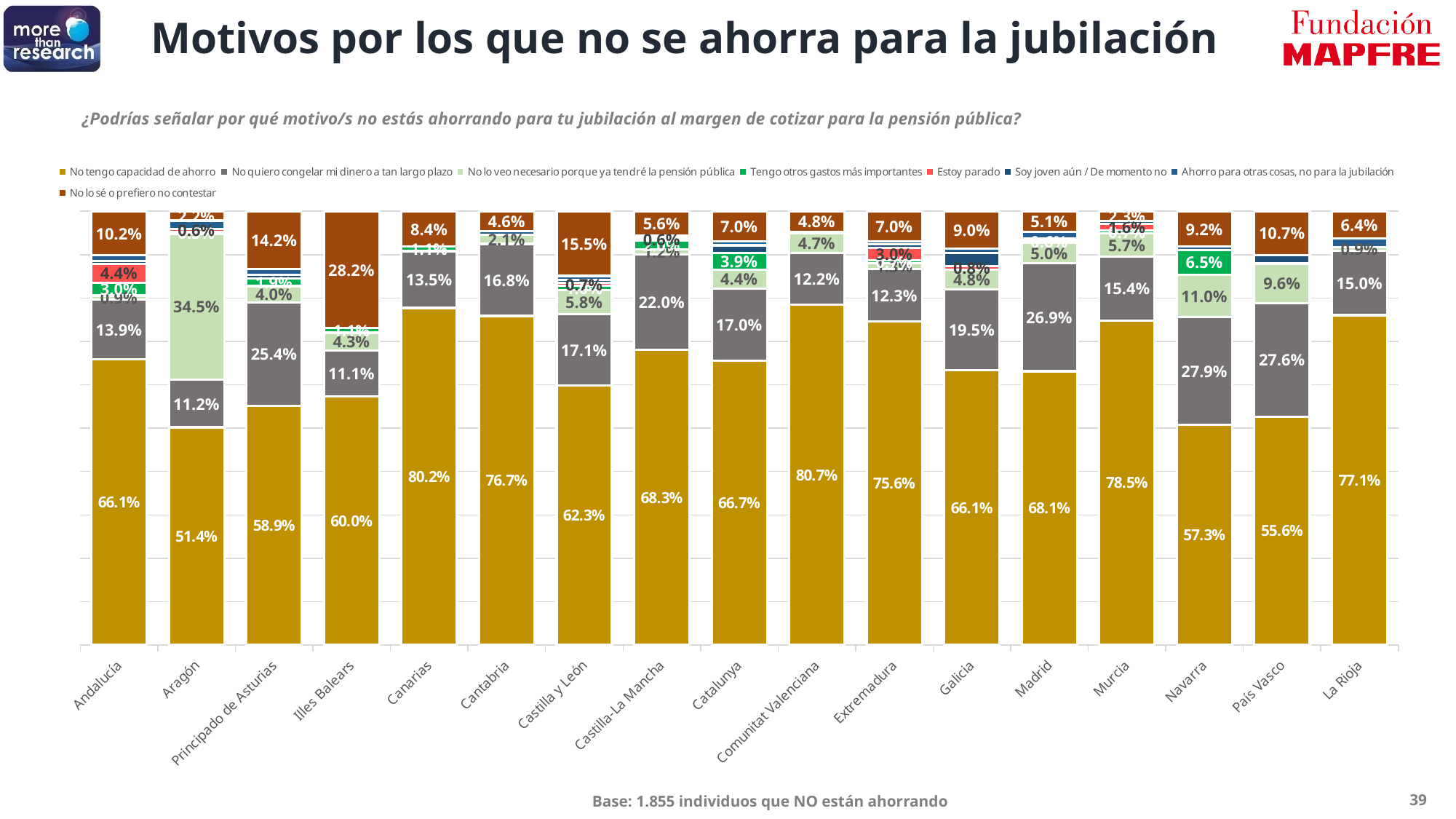
What is the value of 'Tengo otros gastos más importantes' for Navarra? 6.5% Which is larger: the 'No quiero congelar mi dinero a tan largo plazo' value for Navarra or for País Vasco? Navarra Which region has the highest value for 'No tengo capacidad de ahorro'? Comunitat Valenciana How many regions (categories) are shown on the x axis? 17 Which region has the lowest value for 'No tengo capacidad de ahorro'? Aragón How many series does the legend list? 8 What kind of chart is shown on the slide? Stacked bar chart What is the difference between the 'No tengo capacidad de ahorro' values for Canarias and Navarra? 22.9% What is the value of 'No quiero congelar mi dinero a tan largo plazo' for Madrid? 26.9% What is the value of 'No lo veo necesario porque ya tendré la pensión pública' for Aragón? 34.5% What is the value of 'No tengo capacidad de ahorro' for Aragón? 51.4% What is the value of 'No lo sé o prefiero no contestar' for Illes Balears? 28.2%